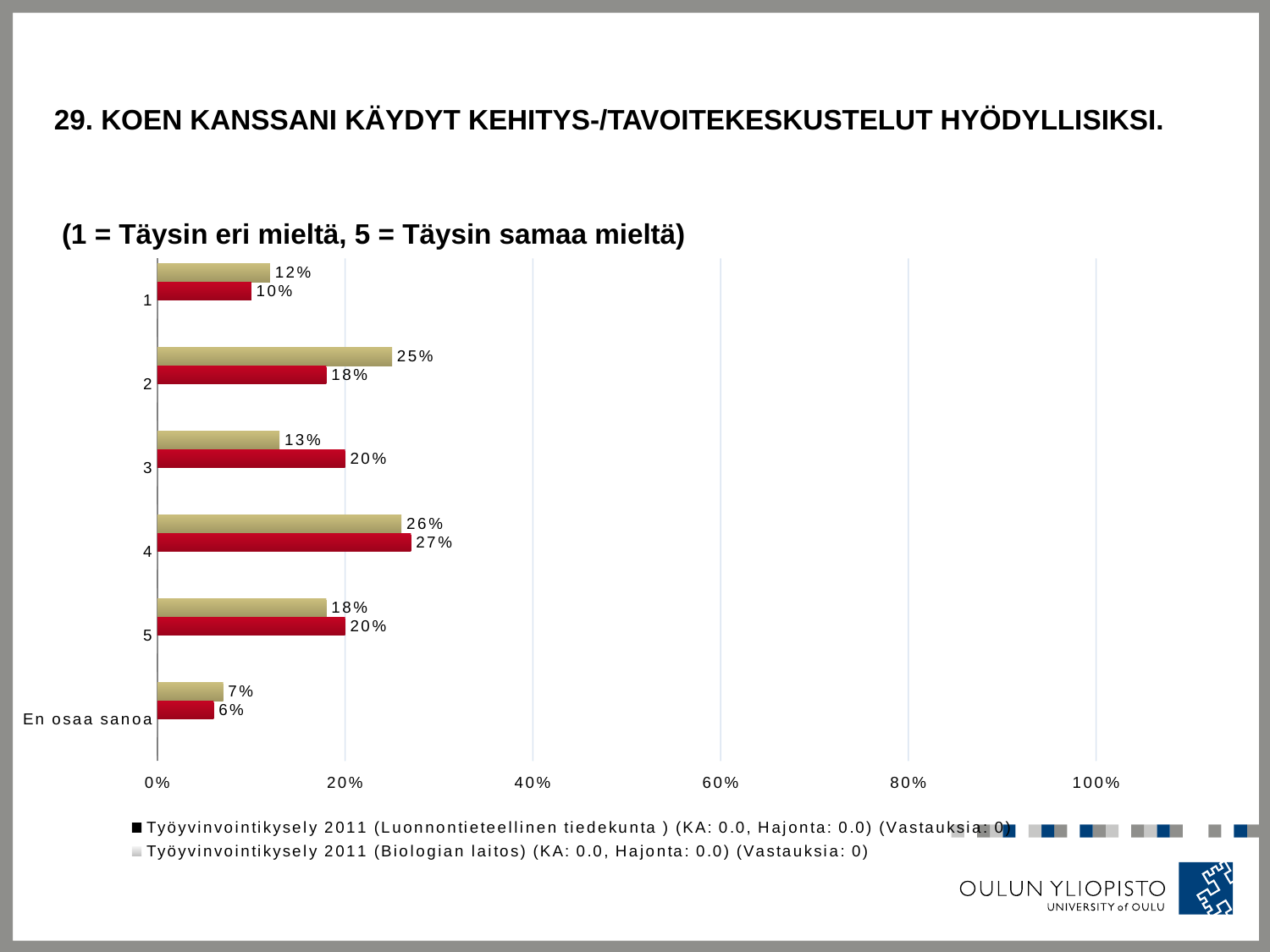
Which category has the lowest value among the tan bars? En osaa sanoa What kind of chart is shown on the slide? bar chart Is the value of the red bar for category 4 greater or less than 20%? greater What is the difference between the tan bar and the red bar for category 2? 7% What is the value of the red bar for category 3? 20% For category 3, which bar is larger, the red bar or the tan bar? the red bar What is the value of the red bar for 'En osaa sanoa'? 6% What is the highest value shown on the horizontal axis of the chart? 100% Which category has the highest value among the red bars? 4 What is the value of the tan bar for category 2? 25% How many categories are shown on the vertical axis of the chart? 6 How many series does the legend list? 2